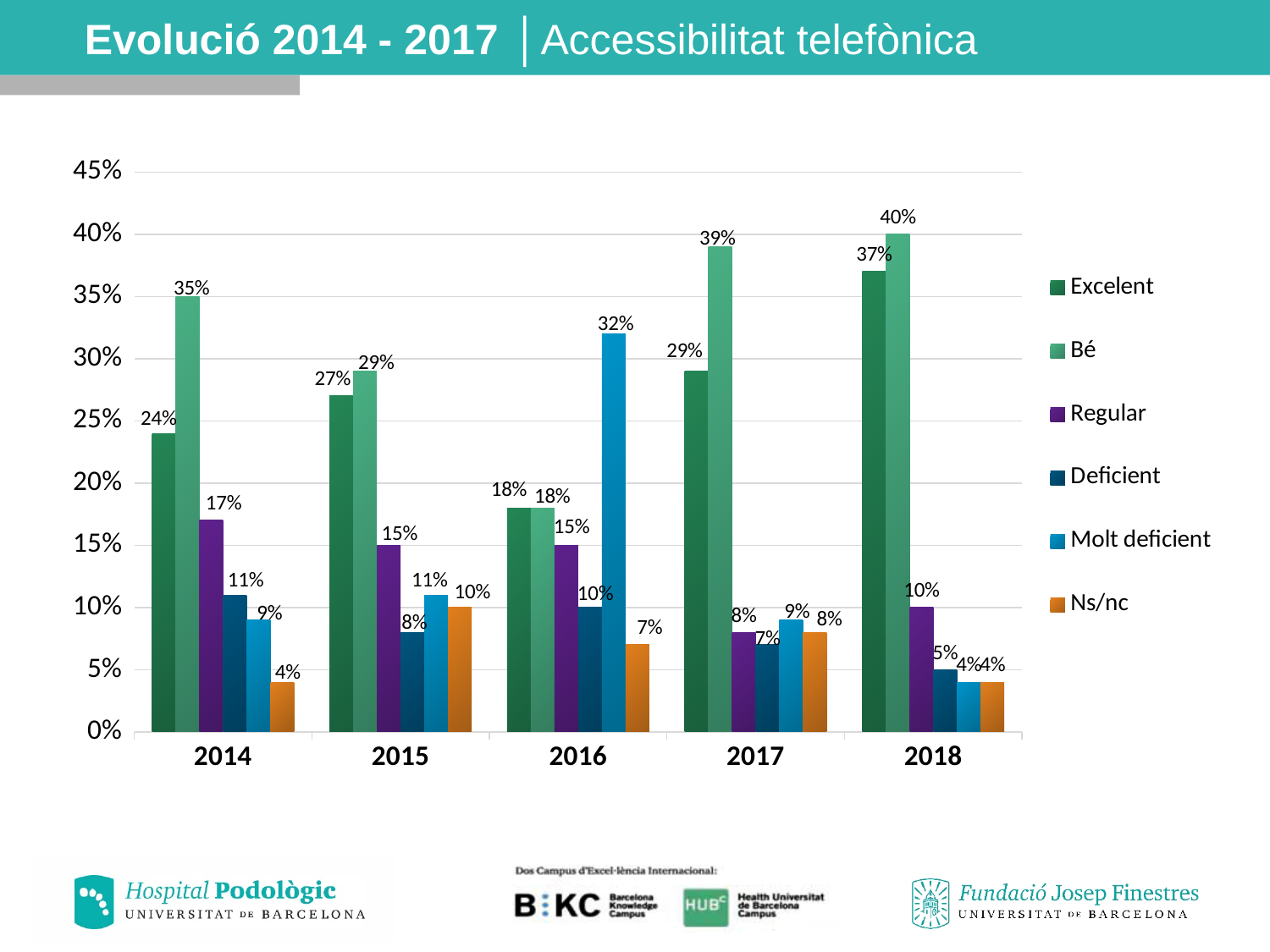
What is the value for Excelent in 2018? 37% What kind of chart is shown on the slide? Bar chart How many series does the legend list? 6 In which year is the Bé value highest? 2018 What is the value for Molt deficient in 2016? 32% What is the value for Bé in 2014? 35% How many years are shown on the x axis? 5 Does the Regular value rise or fall from 2014 to 2017? Fall What is the difference between the Bé and Excelent values in 2017? 10% In which year is the Excelent value lowest? 2016 Which is larger in 2015: Excelent or Bé? Bé What is the value for Ns/nc in 2015? 10%